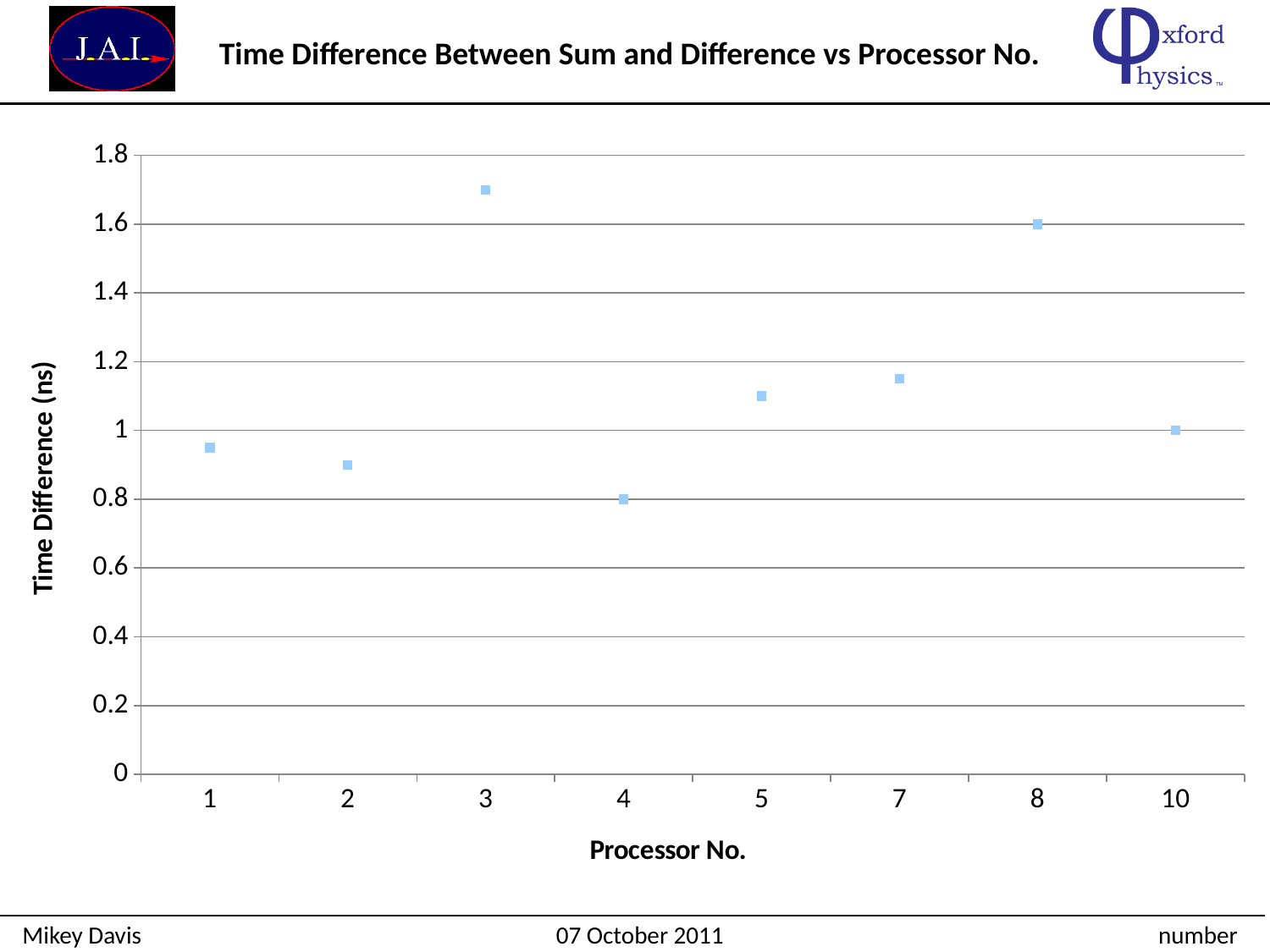
What is the label on the y axis? Time Difference (ns) Is the time difference for processor 1 greater or less than 1? less Which processor number has the lowest time difference? 4 Is the time difference for processor 5 greater or less than 1? greater What is the time difference for processor 10? 1 Is the time difference for processor 3 greater or less than 1.6? greater What is the time difference for processor 4? 0.8 What kind of chart is shown on the slide? Scatter chart What is the time difference for processor 8? 1.6 How many processor numbers are plotted on the x axis? 8 Which has a larger time difference, processor 2 or processor 7? Processor 7 Which processor number has the highest time difference? 3